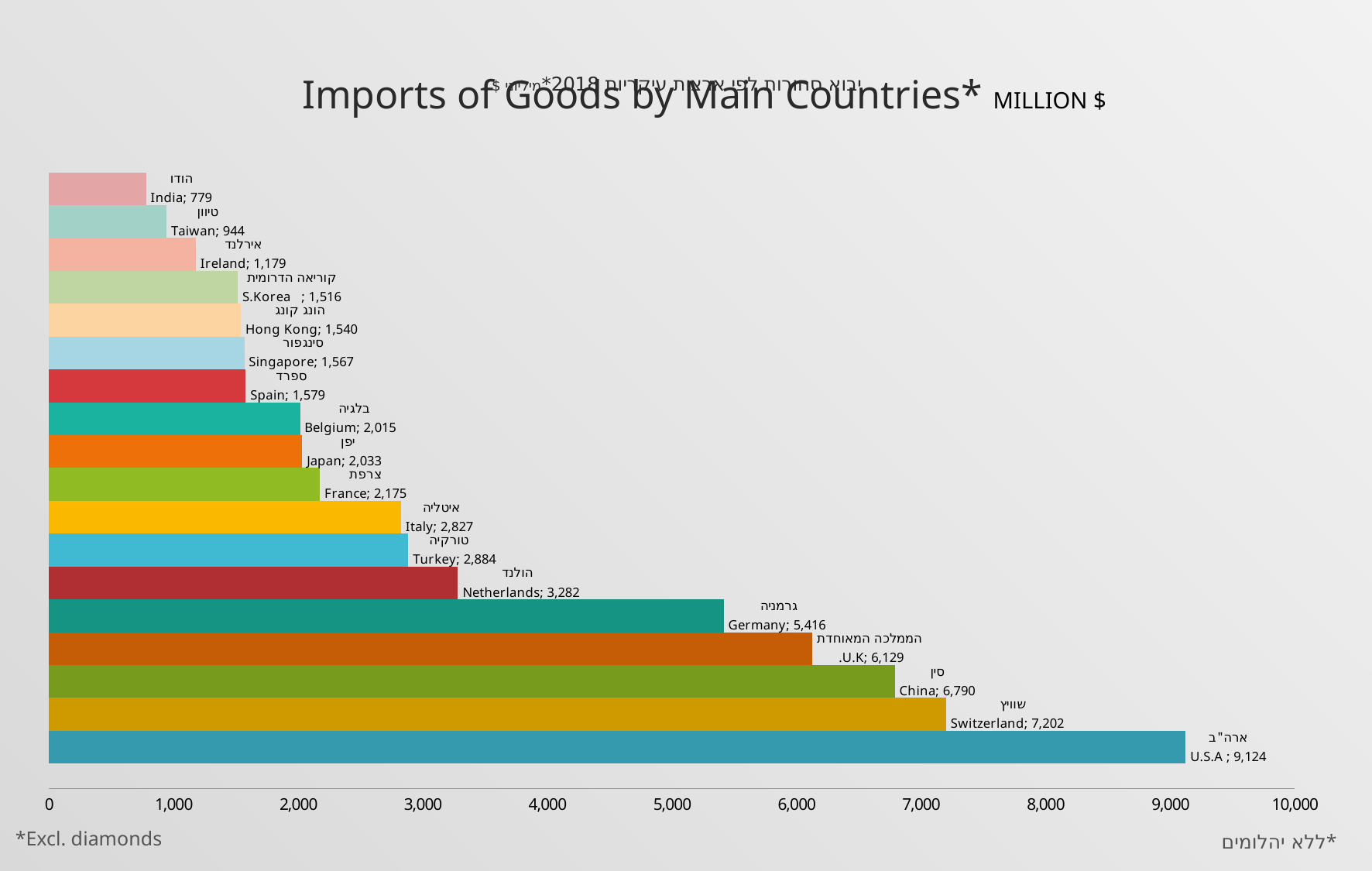
How many countries are shown in the chart? 18 What is the difference between the values for U.S.A and Switzerland? 1,922 Which country has the lowest value? India What unit is stated next to the chart title? MILLION $ Which country has the highest value? U.S.A What is the value for India? 779 What kind of chart is shown on the slide? bar chart What is the value for Switzerland? 7,202 Which is larger, the value for Italy or the value for Turkey? Turkey What is the value for Germany? 5,416 What is the difference between the values for China and the U.K? 661 Is the value for Netherlands greater or less than 3,000? greater